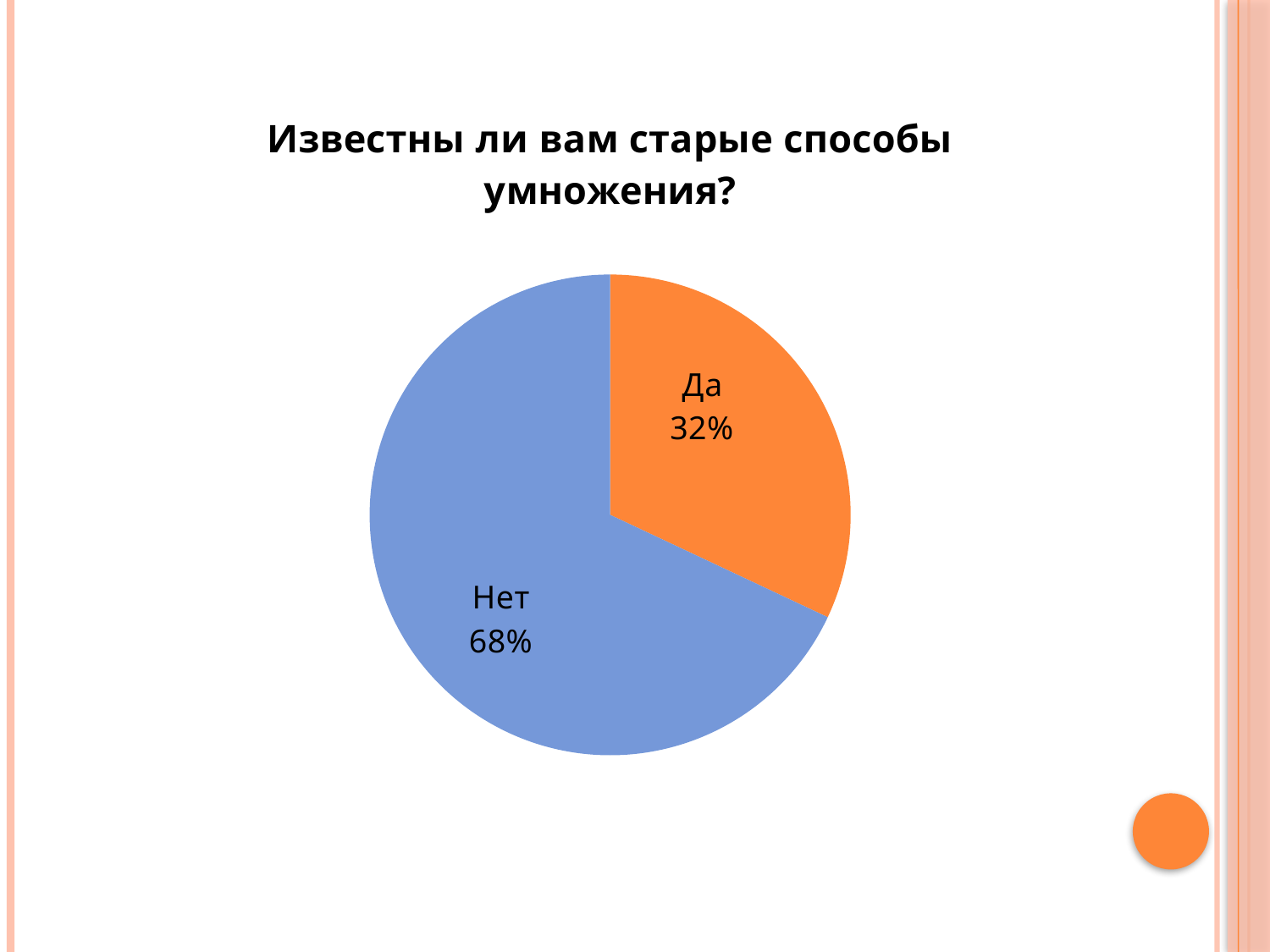
What share of the pie does the "Нет" slice represent? 68% What is the difference in percentage points between the "Нет" and "Да" slices? 36 Which slice is the largest in the pie chart? Нет What kind of chart is shown on the slide? pie chart Which slice is the smallest in the pie chart? Да What is the title of the chart? Известны ли вам старые способы умножения? How many slices does the pie chart have? 2 Which is larger, the "Да" slice or the "Нет" slice? Нет What share of the pie does the "Да" slice represent? 32% What colour is the "Да" slice? orange What is the total of the two slice percentages shown? 100%